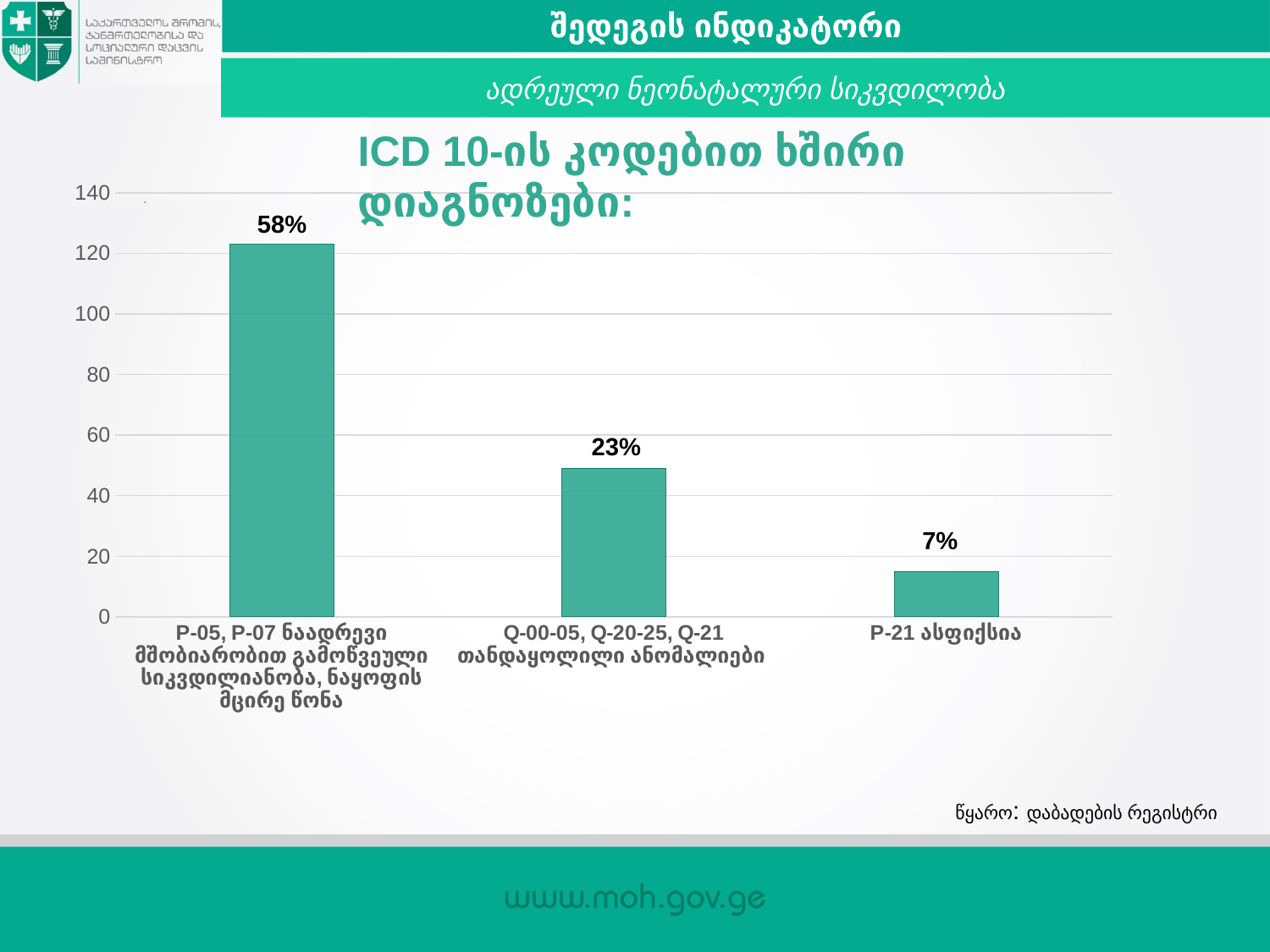
Is the bar for Q-00-05, Q-20-25, Q-21 თანდაყოლილი ანომალიები greater or less than 60 on the y axis? less What is the data label shown on the bar for Q-00-05, Q-20-25, Q-21 თანდაყოლილი ანომალიები? 23% What is the difference in percentage points between the labels for P-05, P-07 and Q-00-05, Q-20-25, Q-21? 35 percentage points What is the data label shown on the bar for P-21 ასფიქსია? 7% What is the title of the chart? ICD 10-ის კოდებით ხშირი დიაგნოზები: Is the bar for P-05, P-07 ნაადრევი მშობიარობით გამოწვეული სიკვდილიანობა greater or less than 100 on the y axis? greater What is the data label shown on the bar for P-05, P-07 ნაადრევი მშობიარობით გამოწვეული სიკვდილიანობა, ნაყოფის მცირე წონა? 58% Which category has the highest bar in the chart? P-05, P-07 ნაადრევი მშობიარობით გამოწვეული სიკვდილიანობა, ნაყოფის მცირე წონა Which is larger: the bar for Q-00-05, Q-20-25, Q-21 თანდაყოლილი ანომალიები or the bar for P-21 ასფიქსია? Q-00-05, Q-20-25, Q-21 თანდაყოლილი ანომალიები What kind of chart is shown on the slide? bar chart How many categories are shown in the chart? 3 Which category has the lowest bar in the chart? P-21 ასფიქსია